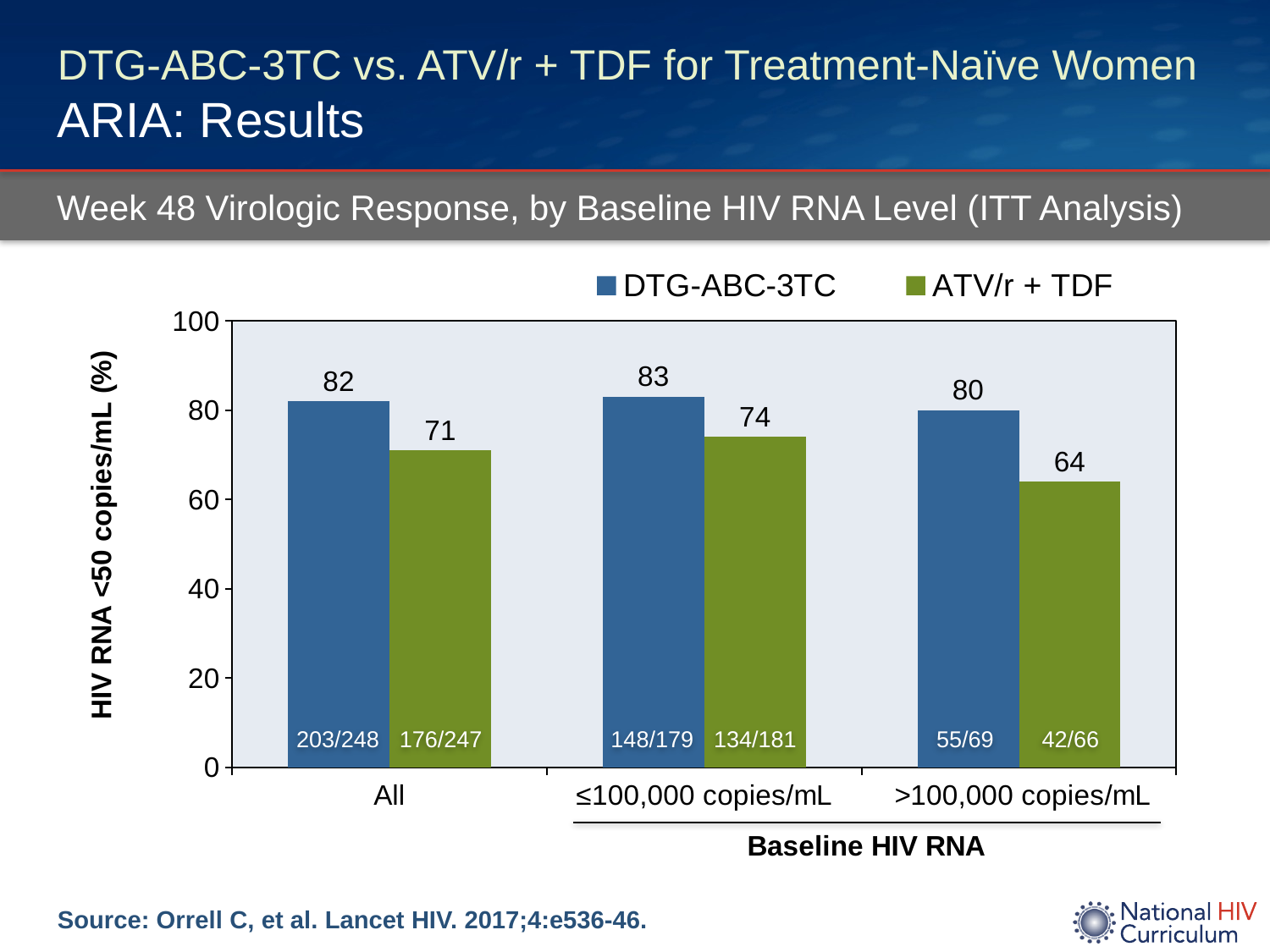
Which category has the lowest value for ATV/r + TDF? >100,000 copies/mL How many categories are shown on the x axis? 3 What is the difference between DTG-ABC-3TC and ATV/r + TDF in the >100,000 copies/mL category? 16 What fraction is printed on the DTG-ABC-3TC bar for the >100,000 copies/mL category? 55/69 What is the value for DTG-ABC-3TC in the All category? 82 What is the difference between DTG-ABC-3TC and ATV/r + TDF in the All category? 11 Which category has the highest value for DTG-ABC-3TC? ≤100,000 copies/mL What is the value for ATV/r + TDF in the ≤100,000 copies/mL category? 74 How many series does the legend list? 2 What kind of chart is shown on the slide? Bar chart Which is larger in the ≤100,000 copies/mL category, DTG-ABC-3TC or ATV/r + TDF? DTG-ABC-3TC What is the value for ATV/r + TDF in the >100,000 copies/mL category? 64